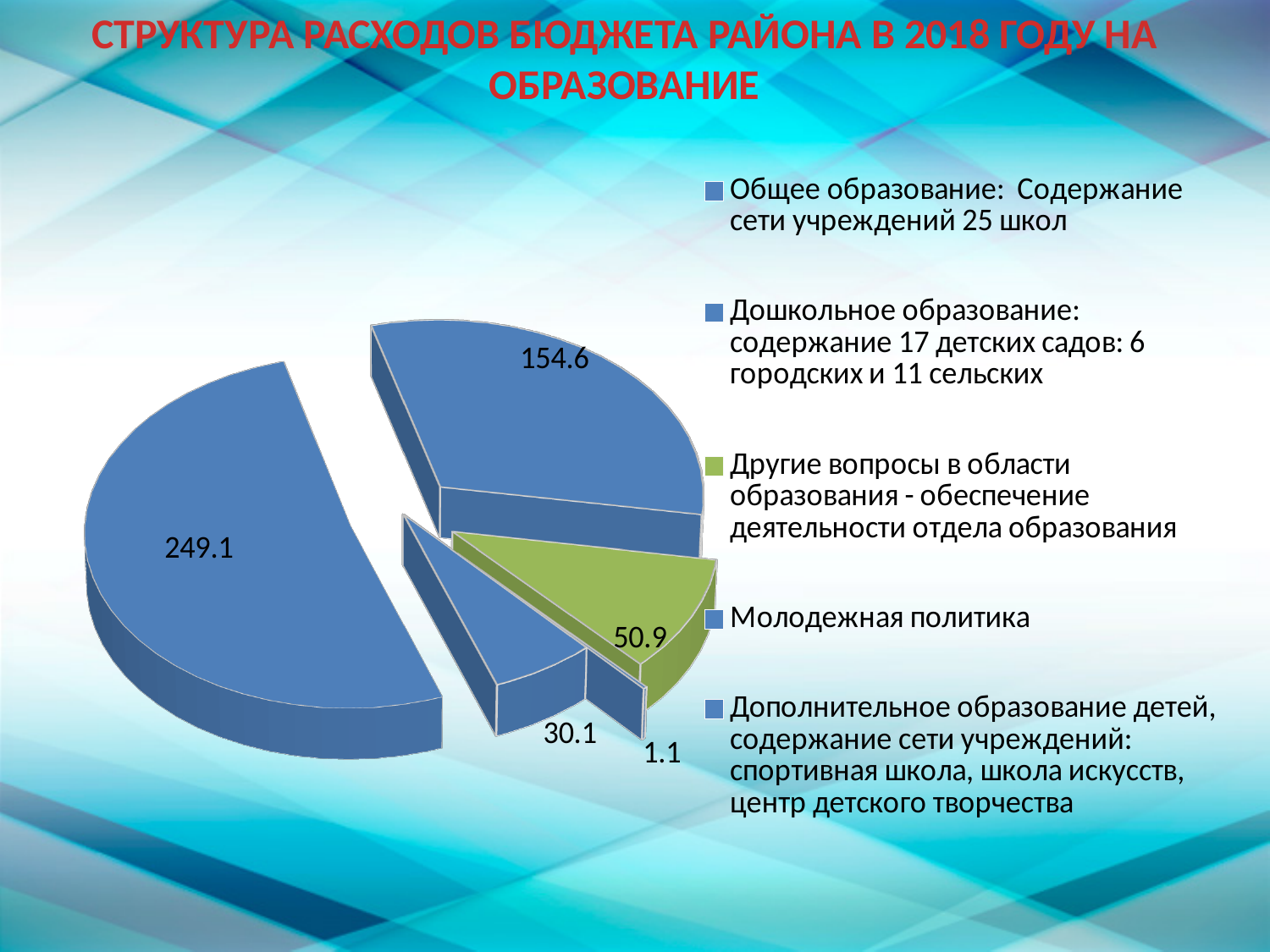
What kind of chart is shown on the slide? pie chart What is the value shown for Дошкольное образование? 154.6 What is the total of all slice values in the pie chart? 485.8 What is the value of the smallest slice in the pie chart? 1.1 What is the value of the green slice (Другие вопросы в области образования)? 50.9 What is the value shown for Общее образование: Содержание сети учреждений 25 школ? 249.1 How many entries does the legend list? 5 How many slices does the pie chart have? 5 What is the difference between the two largest slices, 249.1 and 154.6? 94.5 Which is larger: the slice labelled 30.1 or the slice labelled 50.9? 50.9 What is the value of the largest slice in the pie chart? 249.1 What is the title of the chart on the slide? СТРУКТУРА РАСХОДОВ БЮДЖЕТА РАЙОНА В 2018 ГОДУ НА ОБРАЗОВАНИЕ